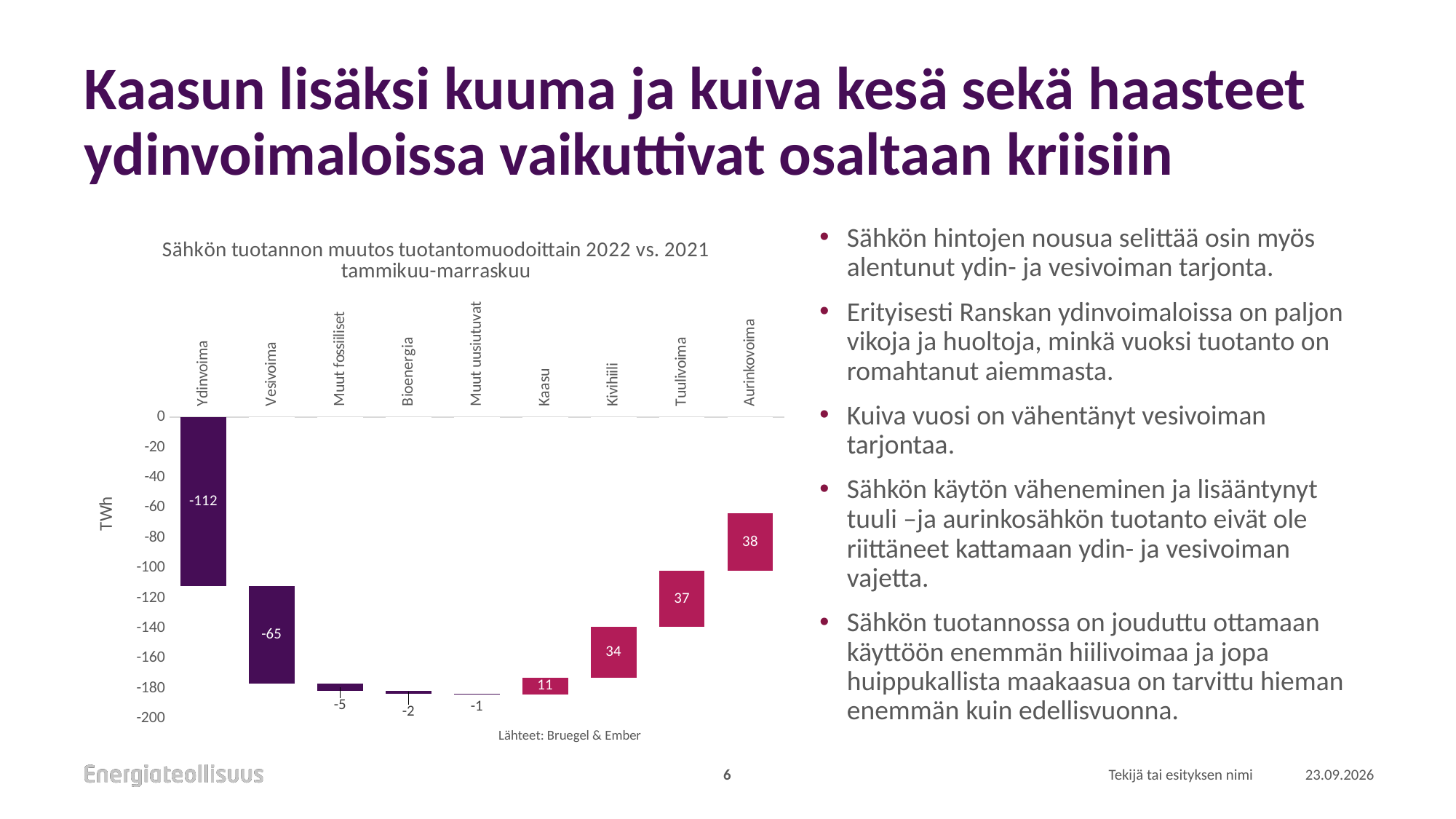
What is the value for Vesivoima? -65 What is the value for Kaasu? 11 Which is larger, the value for Aurinkovoima or the value for Kaasu? Aurinkovoima Which category has the highest value? Aurinkovoima Which category has the lowest value? Ydinvoima How many categories are shown on the x axis? 9 What is the difference between the values for Tuulivoima and Kivihiili? 3 What unit is shown on the y axis of the chart? TWh What is the value for Kivihiili? 34 What sources are cited below the chart? Bruegel & Ember What kind of chart is shown on the slide? bar chart What is the value for Ydinvoima? -112